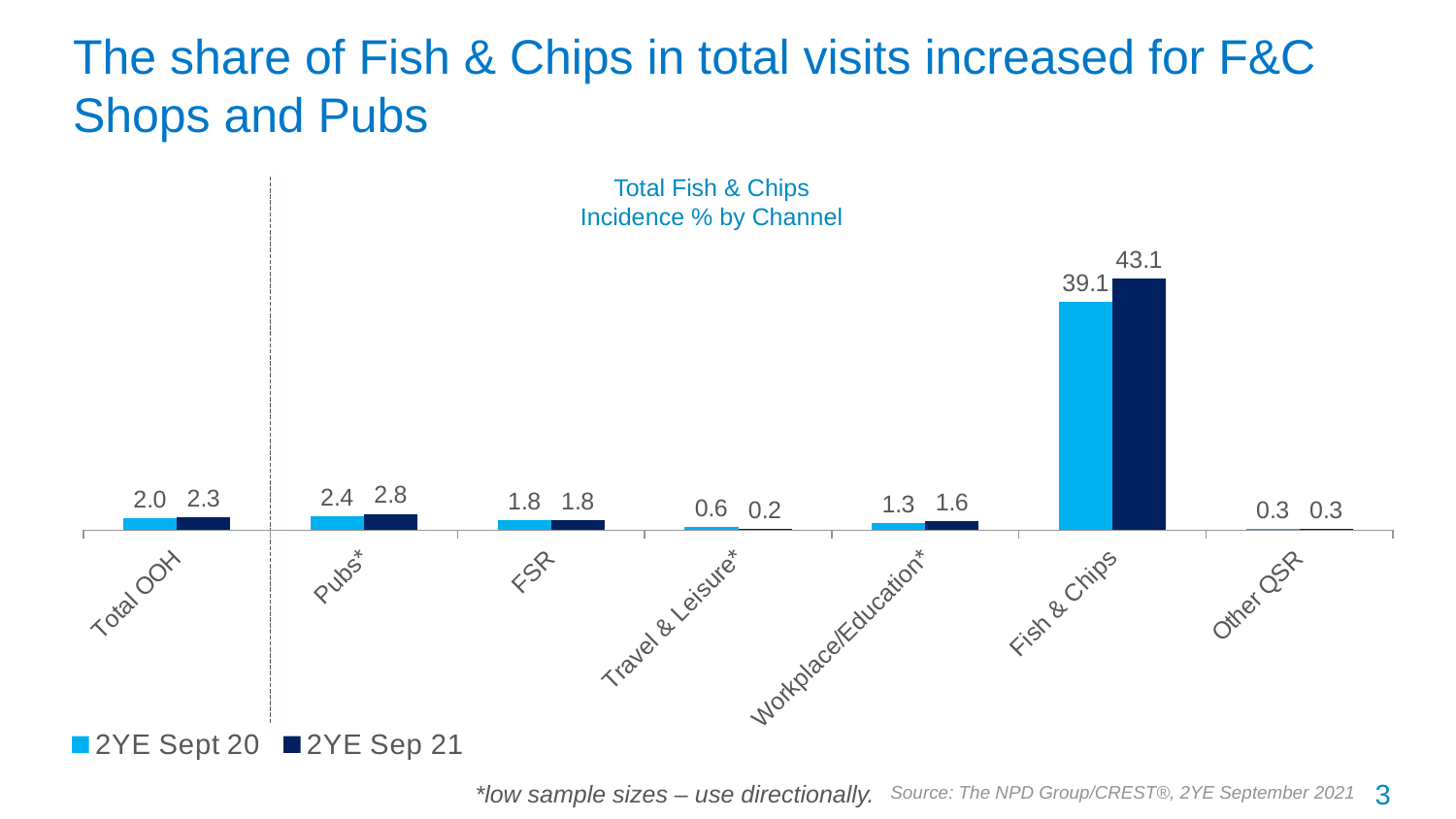
What is the difference between the 2YE Sep 21 and 2YE Sept 20 values for Fish & Chips? 4.0 What is the 2YE Sep 21 value for Total OOH? 2.3 Which is larger for Travel & Leisure*: the 2YE Sept 20 value or the 2YE Sep 21 value? 2YE Sept 20 What is the title of the chart? Total Fish & Chips Incidence % by Channel What kind of chart is shown on the slide? Bar chart How many series does the legend list? 2 How many channels are shown on the x axis? 7 What is the difference between the 2YE Sep 21 and 2YE Sept 20 values for Workplace/Education*? 0.3 Which channel has the lowest 2YE Sep 21 value? Travel & Leisure* What is the 2YE Sep 21 value for Fish & Chips? 43.1 Which channel has the highest 2YE Sep 21 value? Fish & Chips What is the 2YE Sept 20 value for Pubs*? 2.4